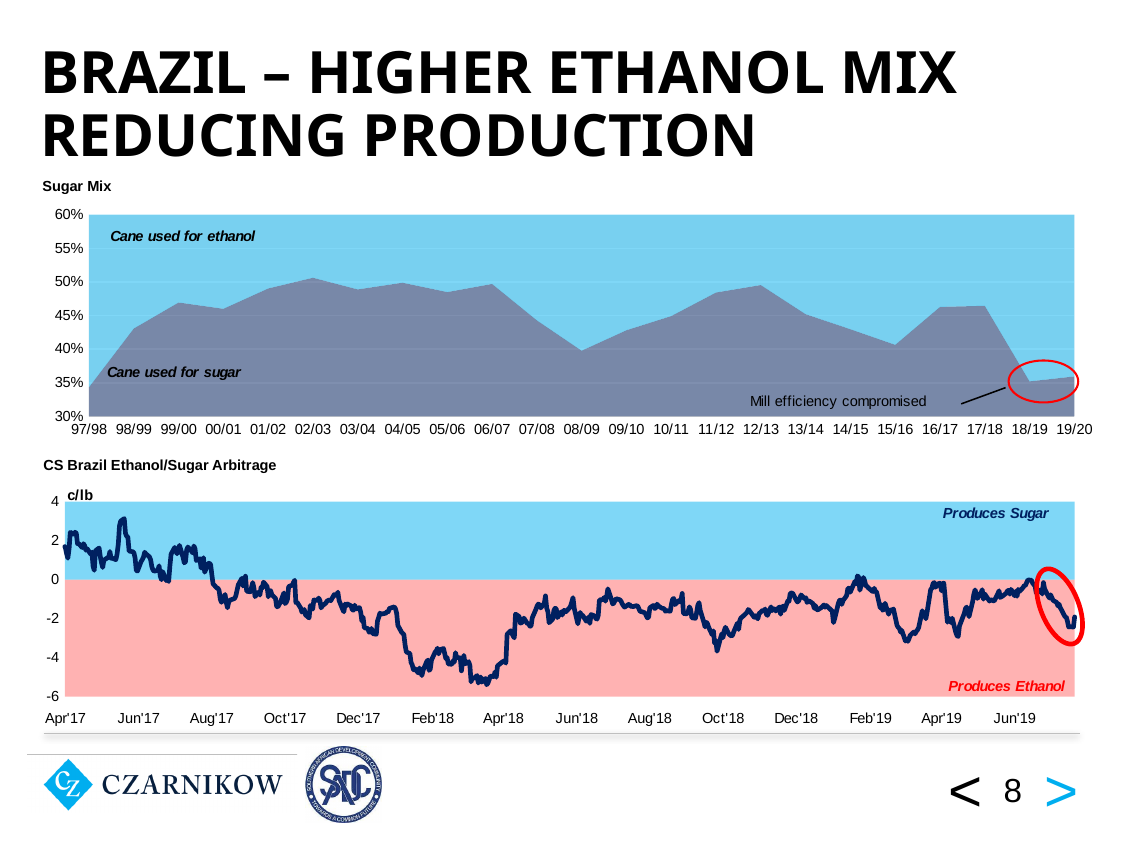
What unit is shown on the y axis of the CS Brazil Ethanol/Sugar Arbitrage chart? c/lb In the CS Brazil Ethanol/Sugar Arbitrage chart, is the value around Feb'18 greater or less than -2? less In the Sugar Mix chart, is the value for 97/98 greater or less than 40%? less In the CS Brazil Ethanol/Sugar Arbitrage chart, is the value at Apr'17 greater or less than 0? greater What type of chart is the Sugar Mix chart? Area chart What annotation is written next to the circled area in the Sugar Mix chart? Mill efficiency compromised What type of chart is the CS Brazil Ethanol/Sugar Arbitrage chart? Line chart In the CS Brazil Ethanol/Sugar Arbitrage chart, does the line overall rise or fall from Apr'17 to Jun'19? Fall How many seasons are shown on the x axis of the Sugar Mix chart? 23